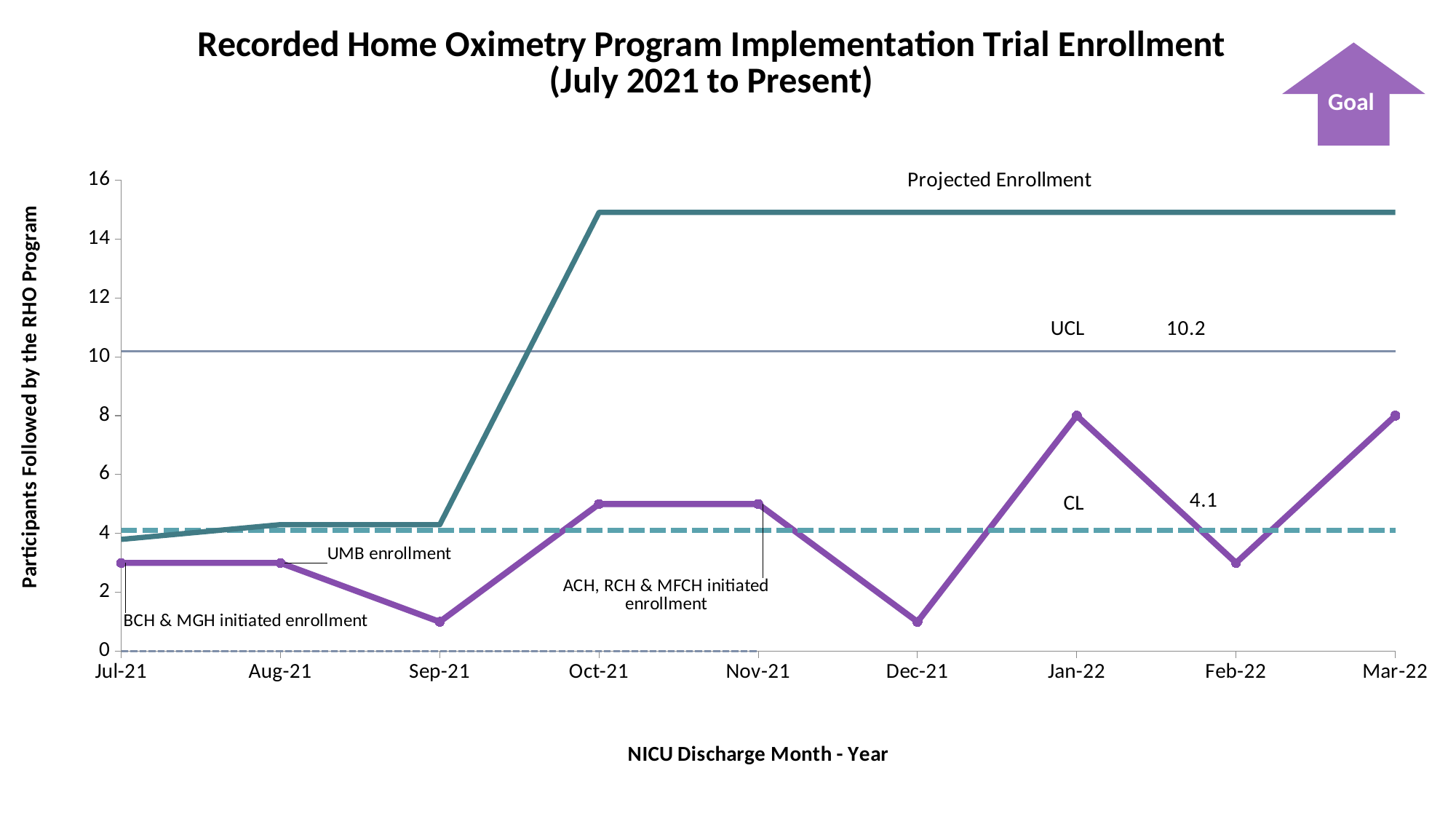
What is the value of the UCL line? 10.2 What is the title of the x axis? NICU Discharge Month - Year What is the title of the y axis? Participants Followed by the RHO Program Is the number of participants for Dec-21 greater or less than 2? less Which month has more participants followed by the RHO Program, Jan-22 or Feb-22? Jan-22 How many months are shown along the x axis? 9 Does the number of participants rise or fall from Feb-22 to Mar-22? rise Is the number of participants for Oct-21 greater or less than 4? greater Is the Projected Enrollment value for Mar-22 greater or less than 14? greater What is the value of the CL line? 4.1 What kind of chart is shown on the slide? line chart How many participants were followed by the RHO Program for Jan-22? 8